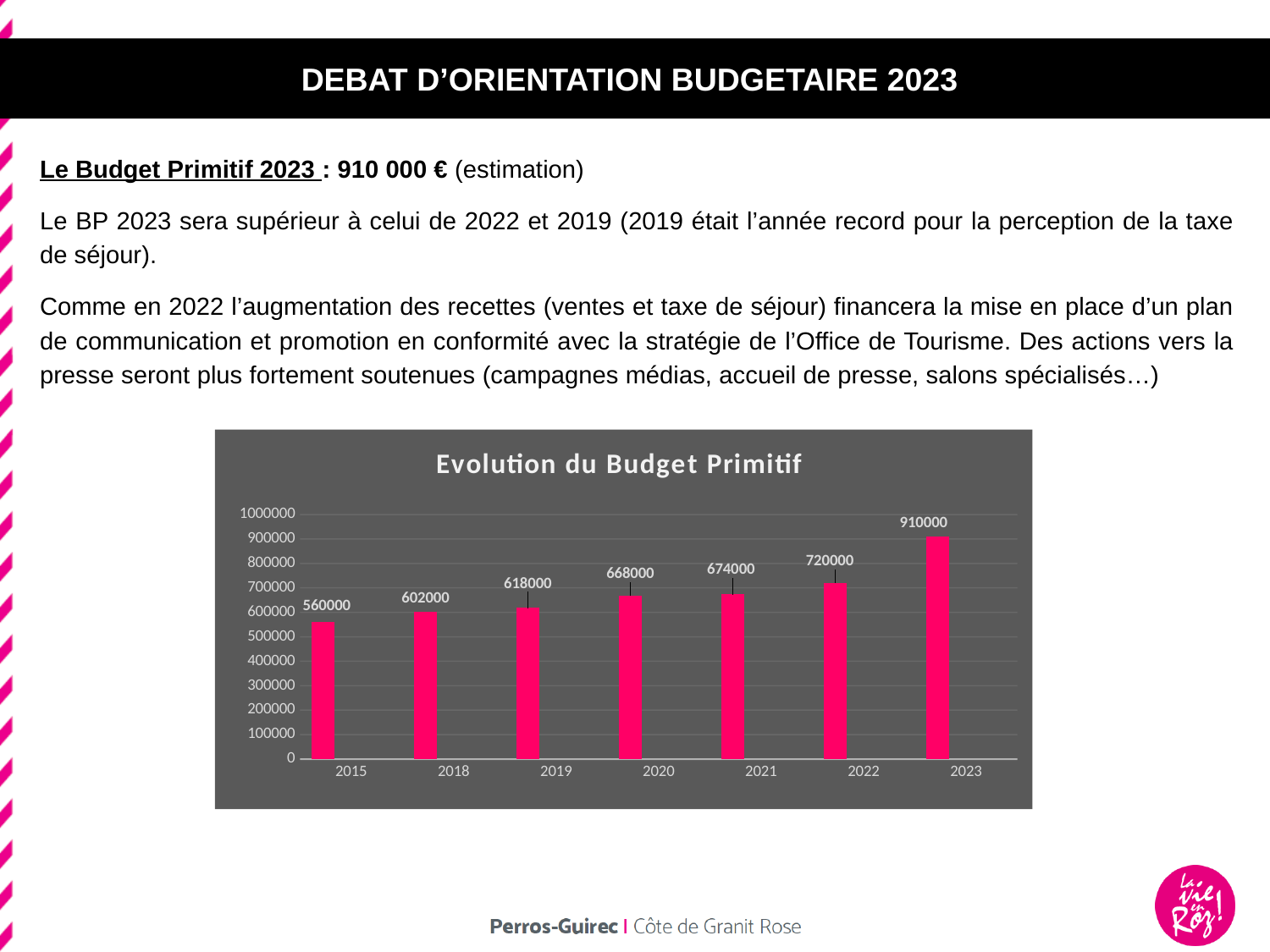
What kind of chart is shown on the slide? bar chart Which is larger, the value for 2020 or the value for 2021? 2021 What is the value for 2015 in the chart? 560000 What is the value for 2022 in the chart? 720000 Is the value for 2023 greater or less than 800000? greater Which year has the highest value in the chart? 2023 Do the values rise or fall from 2015 to 2023? rise What is the difference between the values for 2023 and 2022? 190000 What is the difference between the values for 2018 and 2015? 42000 What is the value for 2019 in the chart? 618000 How many years are shown on the x axis of the chart? 7 Which year has the lowest value in the chart? 2015